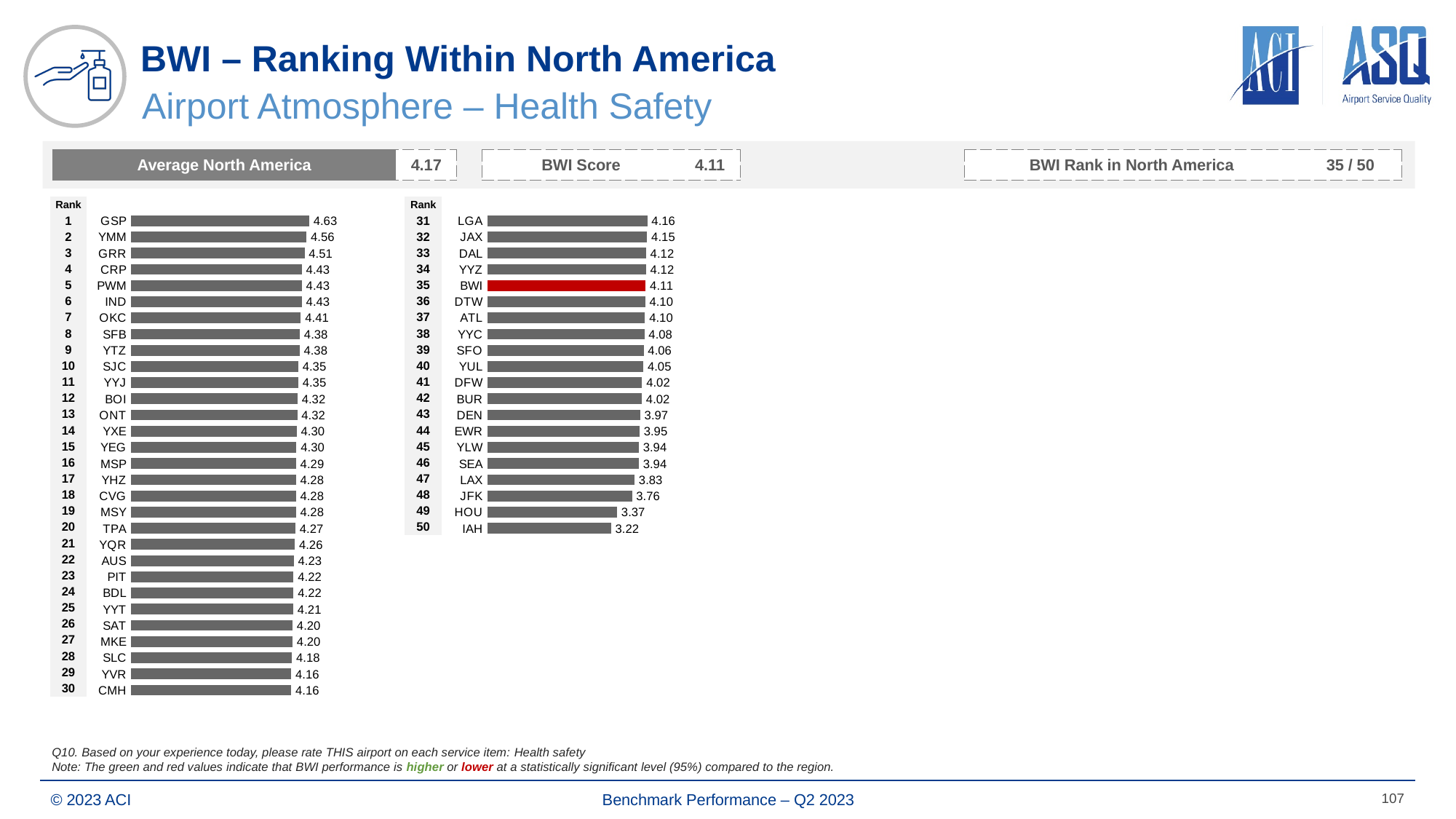
In the right chart (ranks 31–50), which has the larger value, LAX or JFK? LAX How many airports are shown in the left chart (ranks 1–30)? 30 How many airports are shown in the right chart (ranks 31–50)? 20 What is the difference between the value for GSP in the left chart and the value for IAH in the right chart? 1.41 In the right chart (ranks 31–50), which airport's bar is coloured red? BWI What kind of chart is used to show the airport rankings on this slide? Bar chart In the left chart (ranks 1–30), what is the value for GSP? 4.63 In the left chart (ranks 1–30), which airport has the highest value? GSP In the right chart (ranks 31–50), which airport has the lowest value? IAH In the right chart (ranks 31–50), do the values rise or fall going down from rank 31 to rank 50? Fall In the right chart (ranks 31–50), what is the value for BWI? 4.11 In the right chart (ranks 31–50), what is the value for HOU? 3.37